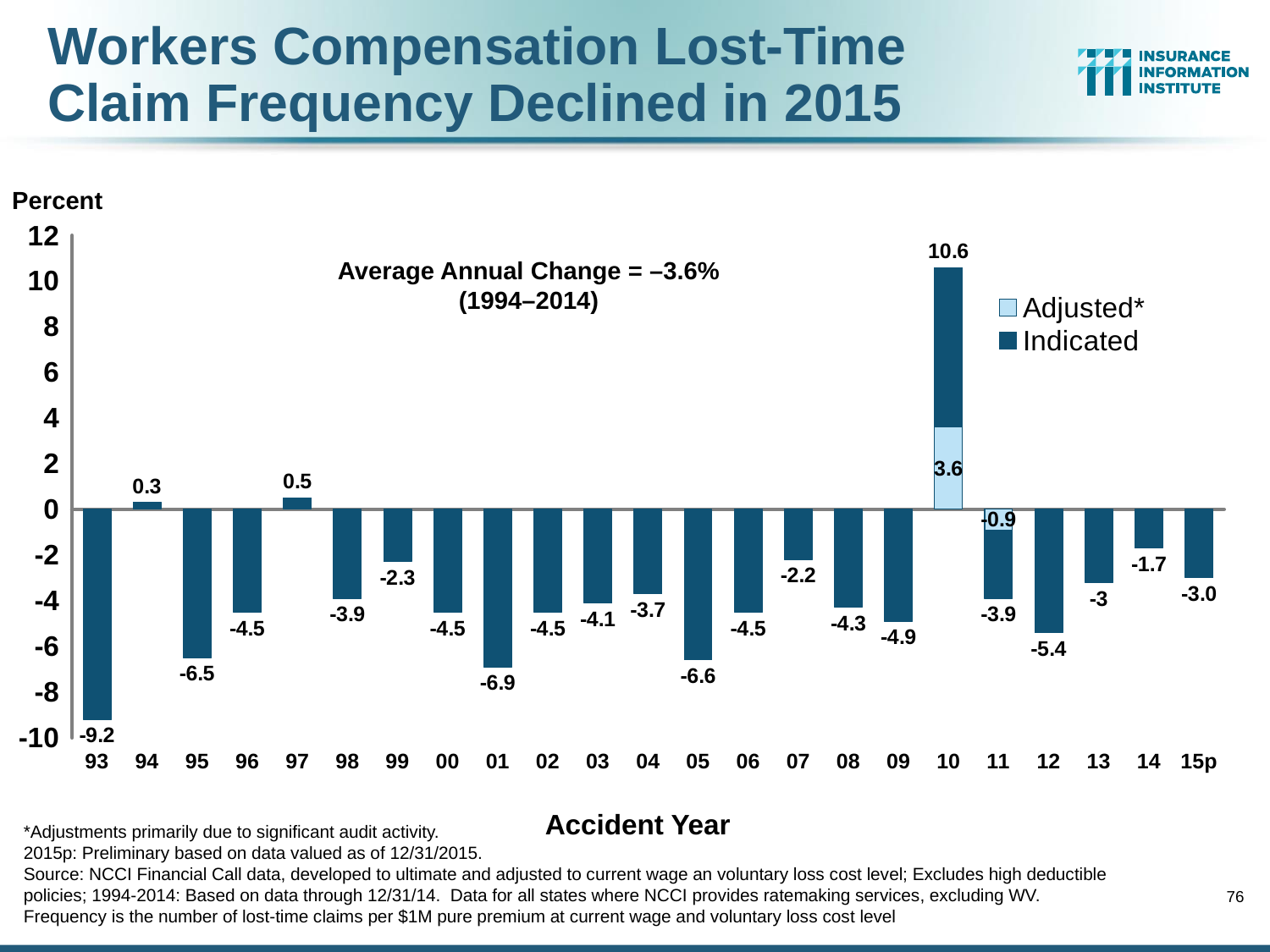
Which accident year has a larger value, 12 or 13? 13 What is the value shown for accident year 15p? -3.0 What is the label of the x axis? Accident Year Which accident year has the lowest value on the chart? 93 What is the value shown for accident year 93? -9.2 How many series does the legend list? 2 What is the difference between the values for accident years 01 and 99? 4.6 What average annual change for 1994–2014 is stated on the chart? –3.6% Which accident year has the highest value on the chart? 10 What is the Adjusted* value shown for accident year 10? 3.6 What kind of chart is shown on the slide? Bar chart How many accident years are shown on the x axis? 23